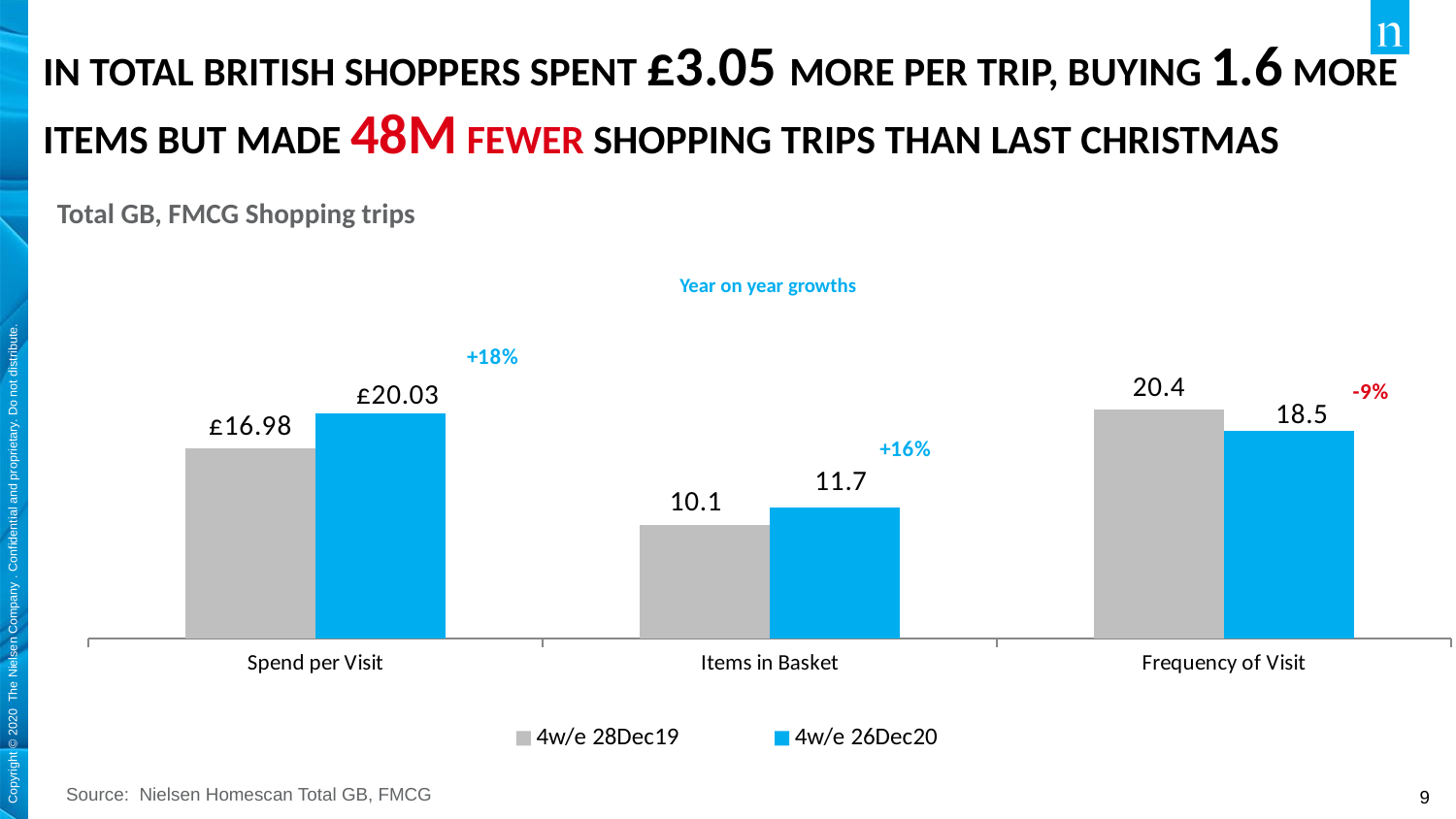
What kind of chart is shown on the slide? Bar chart What is the value for Spend per Visit in the 4w/e 26Dec20 series? £20.03 What is the value for Frequency of Visit in the 4w/e 26Dec20 series? 18.5 How many series does the legend list? 2 What is the difference between the 4w/e 26Dec20 and 4w/e 28Dec19 values for Spend per Visit? £3.05 What is the value for Spend per Visit in the 4w/e 28Dec19 series? £16.98 What is the difference between the 4w/e 26Dec20 and 4w/e 28Dec19 values for Items in Basket? 1.6 For Frequency of Visit, which series has the larger value, 4w/e 28Dec19 or 4w/e 26Dec20? 4w/e 28Dec19 What is the value for Items in Basket in the 4w/e 28Dec19 series? 10.1 What year-on-year growth is shown for Items in Basket? +16% What year-on-year growth is shown for Frequency of Visit? -9% How many categories are shown on the x axis of the chart? 3